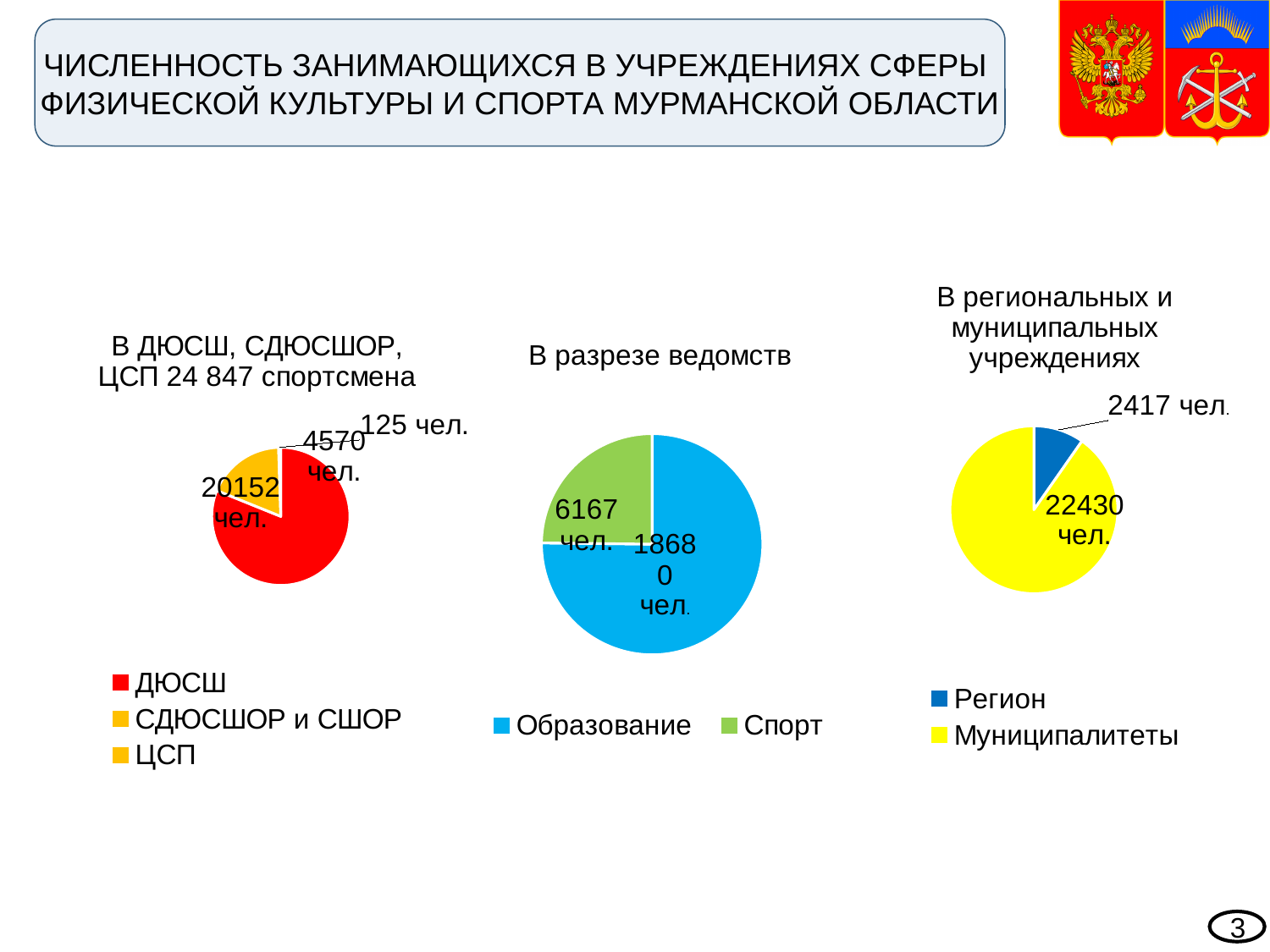
On the left pie chart (В ДЮСШ, СДЮСШОР, ЦСП), which category has the smallest slice? ЦСП On the right pie chart (В региональных и муниципальных учреждениях), what is the difference between the Муниципалитеты and Регион values? 20013 On the right pie chart (В региональных и муниципальных учреждениях), what is the value for Муниципалитеты? 22430 чел. On the middle pie chart (В разрезе ведомств), how many categories does the legend list? 2 On the left pie chart (В ДЮСШ, СДЮСШОР, ЦСП), what is the difference between the ДЮСШ and СДЮСШОР и СШОР values? 15582 On the left pie chart (В ДЮСШ, СДЮСШОР, ЦСП), what is the value for ДЮСШ? 20152 чел. On the right pie chart (В региональных и муниципальных учреждениях), what is the value for Регион? 2417 чел. On the left pie chart (В ДЮСШ, СДЮСШОР, ЦСП), what is the value for ЦСП? 125 чел. On the left pie chart (В ДЮСШ, СДЮСШОР, ЦСП), what is the value for СДЮСШОР и СШОР? 4570 чел. What type of chart is used for all three charts on the slide? Pie chart On the middle pie chart (В разрезе ведомств), what is the value for Спорт? 6167 чел. On the middle pie chart (В разрезе ведомств), which category is larger, Образование or Спорт? Образование